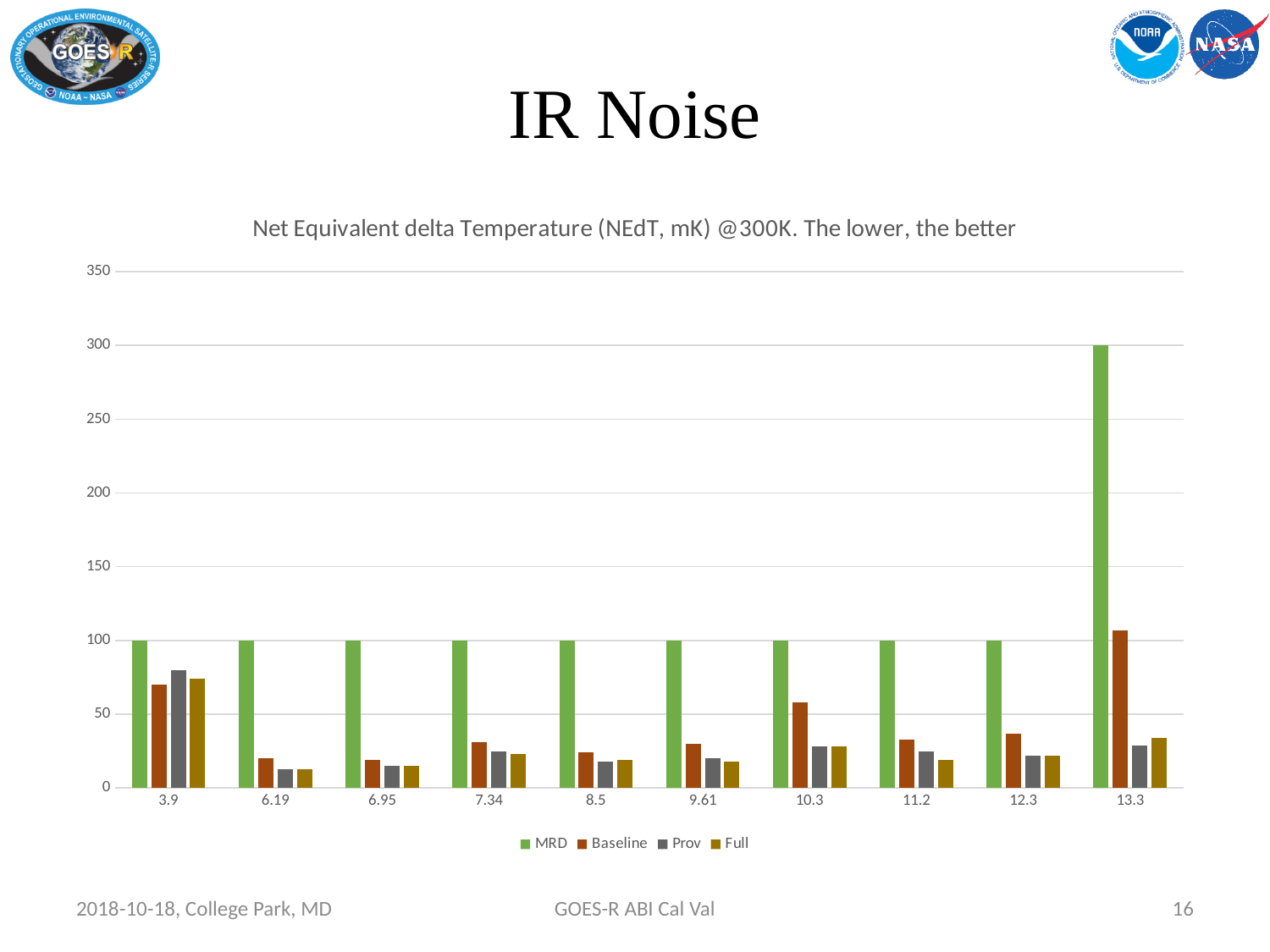
Which category has the highest Baseline value? 13.3 Is the Baseline value for 13.3 greater or less than 100? greater Which category has the larger Baseline value, 10.3 or 11.2? 10.3 What kind of chart is shown on the slide? bar chart Is the Prov value for 6.19 greater or less than 50? less What is the MRD value for the 13.3 category? 300 Is the Baseline value for 3.9 greater or less than 50? greater What is the title of the chart? Net Equivalent delta Temperature (NEdT, mK) @300K. The lower, the better How many categories are shown along the x axis? 10 What is the MRD value for the 6.19 category? 100 How many series does the legend list? 4 Which category has the highest MRD value? 13.3